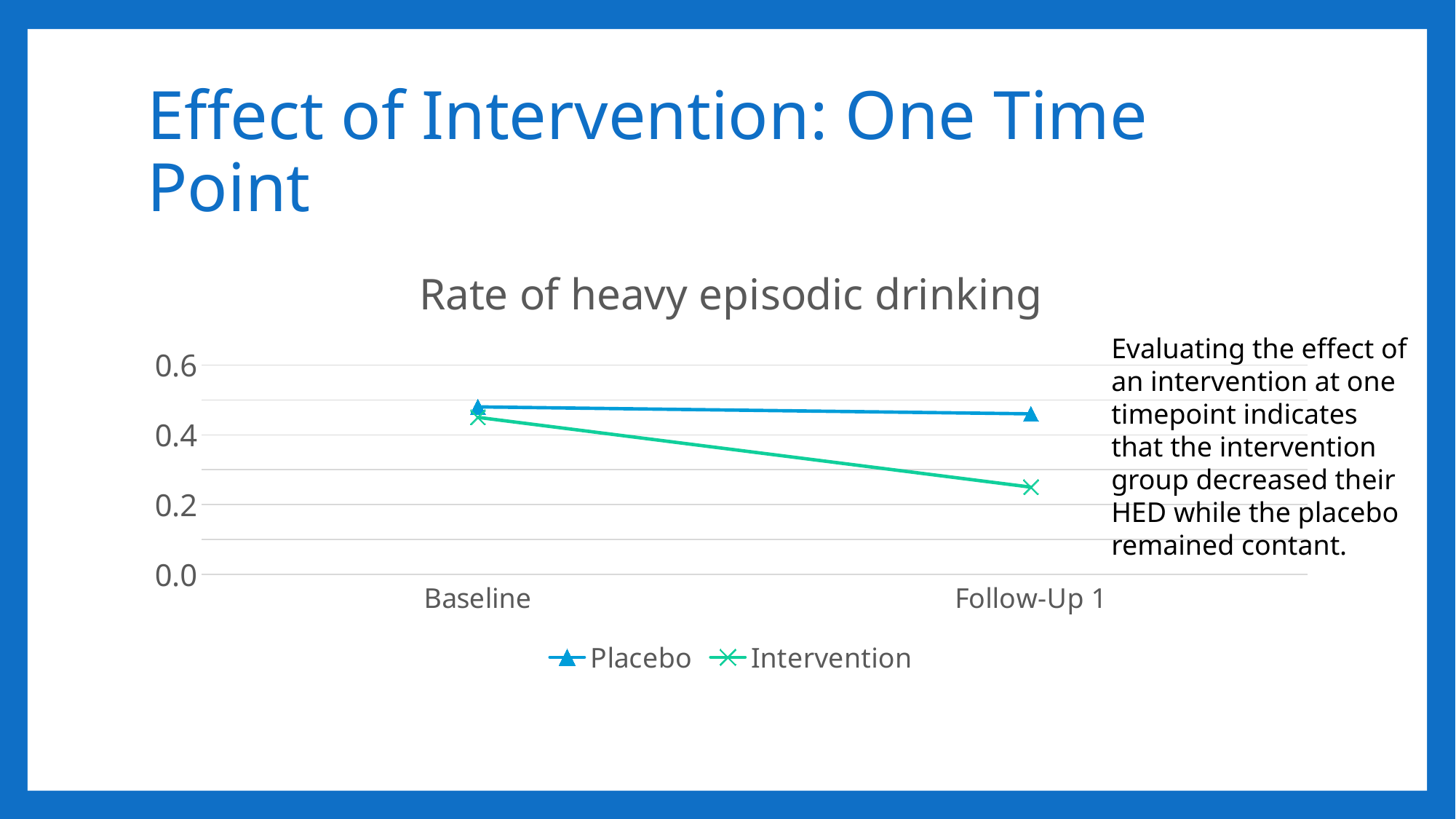
What is the title of the chart? Rate of heavy episodic drinking How many time points are shown on the x axis of the chart? 2 Is the value for Placebo at Baseline greater or less than 0.4? greater Which series has the lowest value at Follow-Up 1? Intervention Is the value for Intervention at Follow-Up 1 greater or less than 0.4? less Which series is plotted with triangle markers? Placebo Is the value for Intervention at Baseline greater or less than 0.2? greater Does the Intervention series rise or fall from Baseline to Follow-Up 1? fall At Follow-Up 1, which series has the higher value, Placebo or Intervention? Placebo What kind of chart is shown on the slide? line chart How many series does the chart legend list? 2